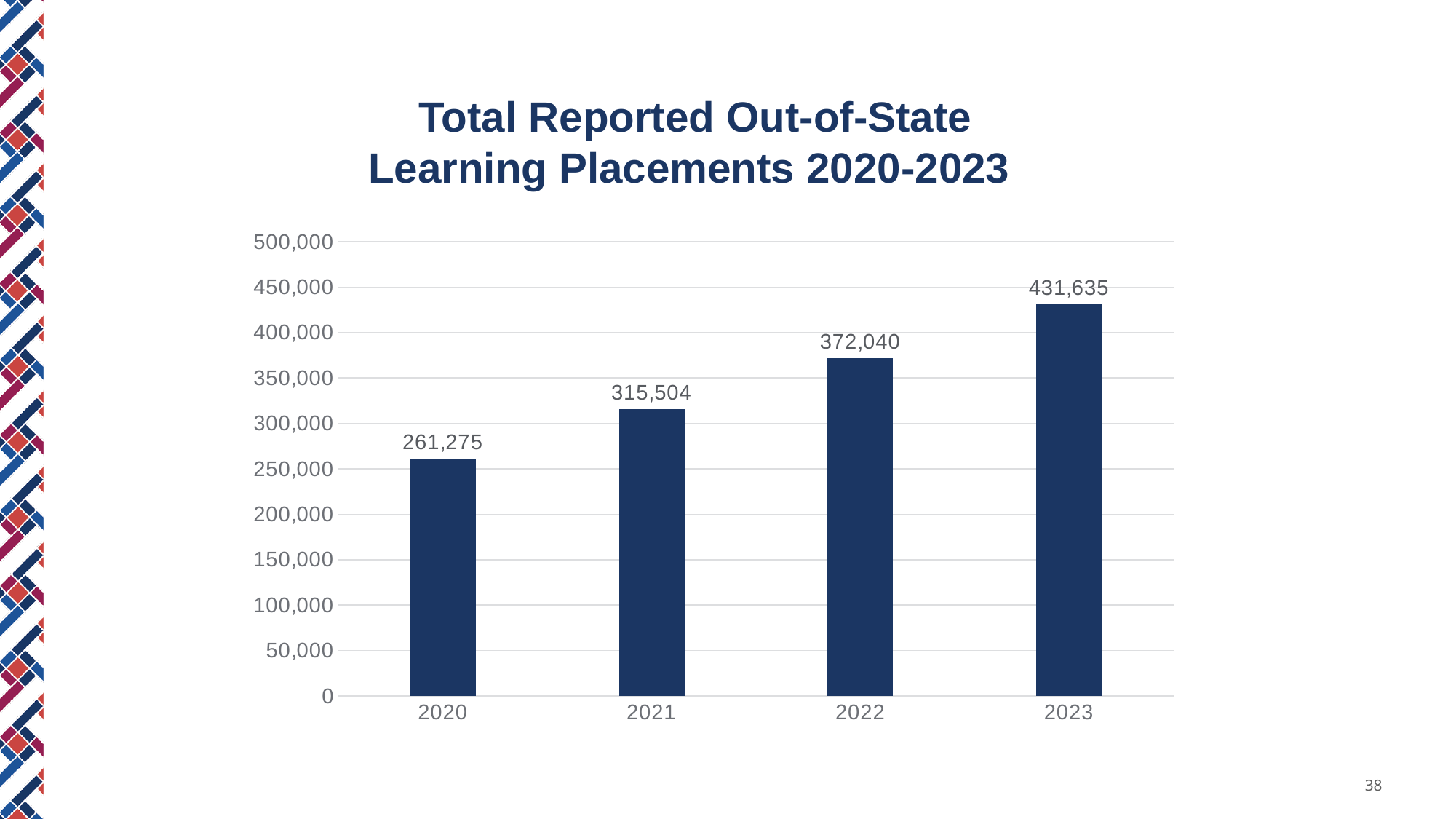
What is the value for 2022? 372,040 Which year has the lowest value? 2020 How many years are shown on the chart? 4 Is the value for 2023 greater or less than 400,000? greater What is the value for 2023? 431,635 Do the values rise or fall from 2020 to 2023? rise What is the value for 2021? 315,504 What is the difference between the values for 2023 and 2020? 170,360 What is the value for 2020? 261,275 Which is larger, the value for 2021 or the value for 2022? 2022 What is the difference between the values for 2022 and 2021? 56,536 Which year has the highest value? 2023